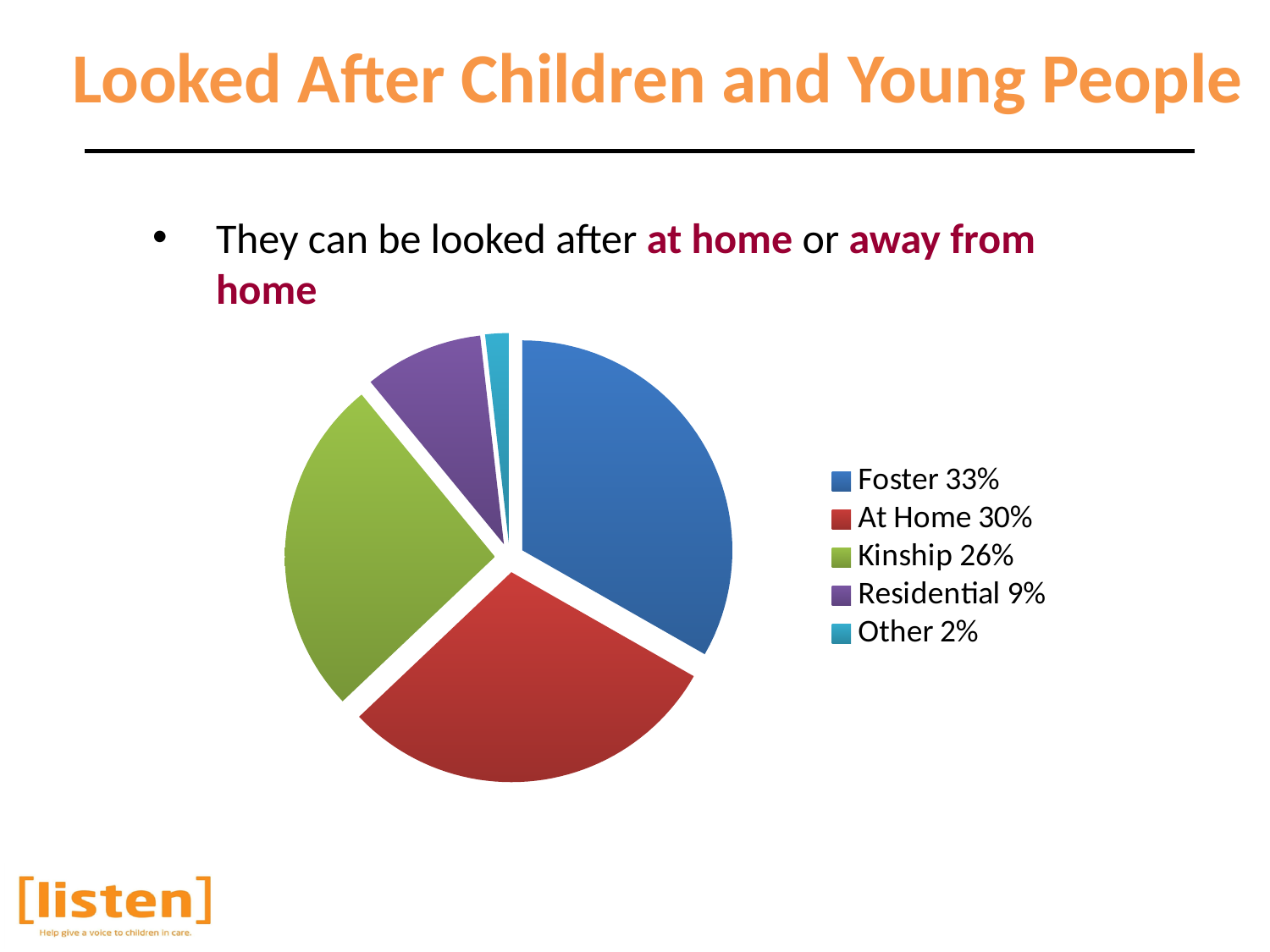
What kind of chart is shown on the slide? pie chart Which category has the smallest share of the pie? Other Which is larger, the share for At Home or the share for Kinship? At Home What percentage does the legend give for Foster? 33% What percentage does the legend give for Kinship? 26% What percentage does the legend give for Residential? 9% What colour is the slice for Kinship? green What is the difference in percentage points between Foster and At Home? 3 What colour is the slice for Other? light blue Which category has the largest share of the pie? Foster How many slices does the pie chart have? 5 What is the difference in percentage points between Kinship and Residential? 17